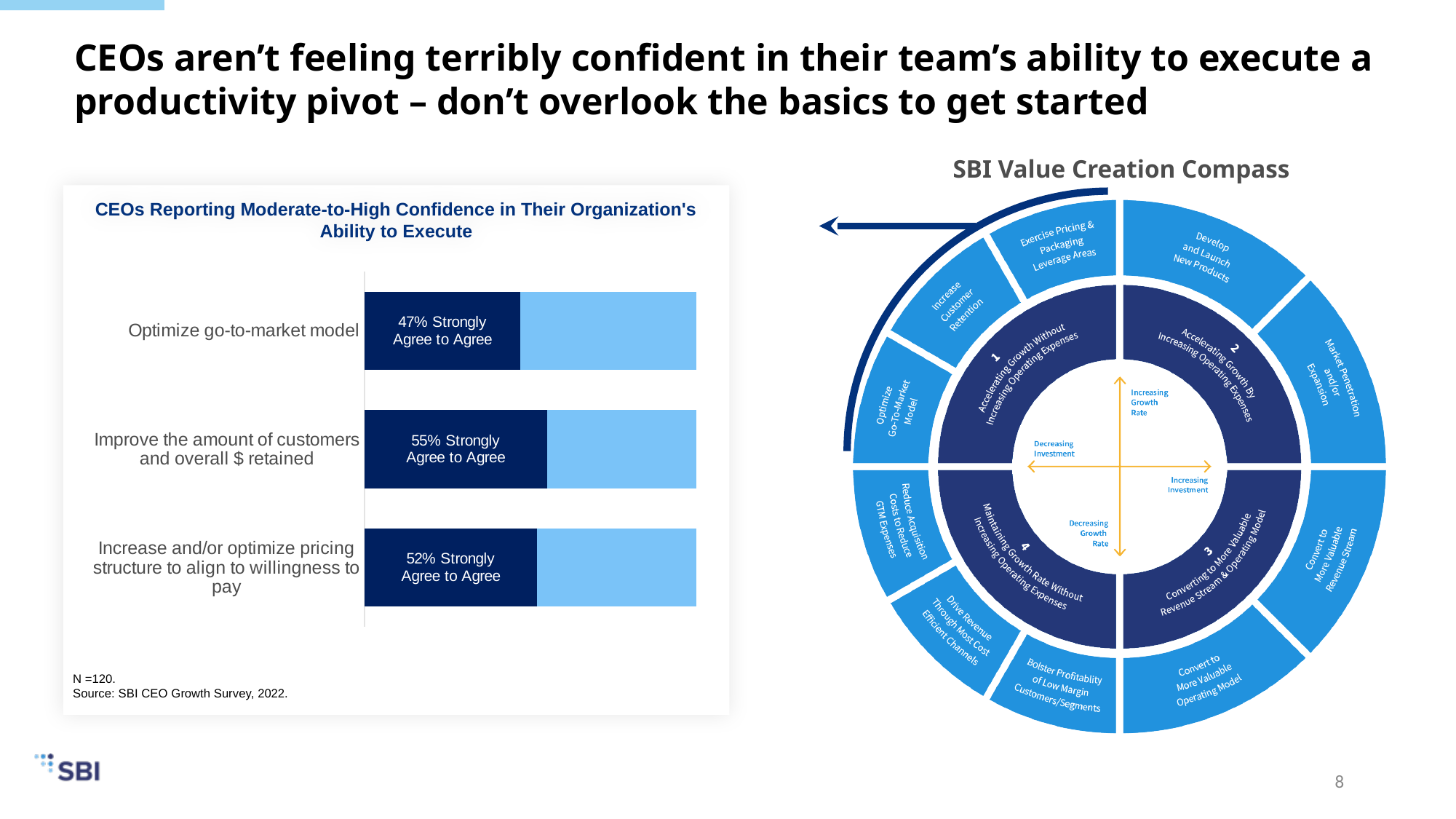
What percentage of CEOs strongly agree to agree regarding confidence in improving the amount of customers and overall $ retained? 55% What is the difference in percentage points between the confidence share for improving customers and $ retained and the share for optimizing the go-to-market model? 8 percentage points Which category has the highest share of CEOs reporting moderate-to-high confidence? Improve the amount of customers and overall $ retained Which category has the lowest share of CEOs reporting moderate-to-high confidence? Optimize go-to-market model What is the title of the chart on the left of the slide? CEOs Reporting Moderate-to-High Confidence in Their Organization's Ability to Execute What is the difference in percentage points between the confidence share for improving customers and $ retained and the share for optimizing pricing structure? 3 percentage points What percentage of CEOs strongly agree to agree regarding confidence in increasing and/or optimizing pricing structure to align to willingness to pay? 52% Which has a larger share of CEOs strongly agreeing to agreeing: optimizing the go-to-market model or optimizing pricing structure? Increase and/or optimize pricing structure to align to willingness to pay What percentage of CEOs strongly agree to agree that they have confidence in their organization's ability to optimize the go-to-market model? 47% How many categories are shown in the bar chart? 3 What type of chart is used to show CEOs' confidence in their organization's ability to execute? Bar chart What is the sample size (N) noted for the bar chart? 120